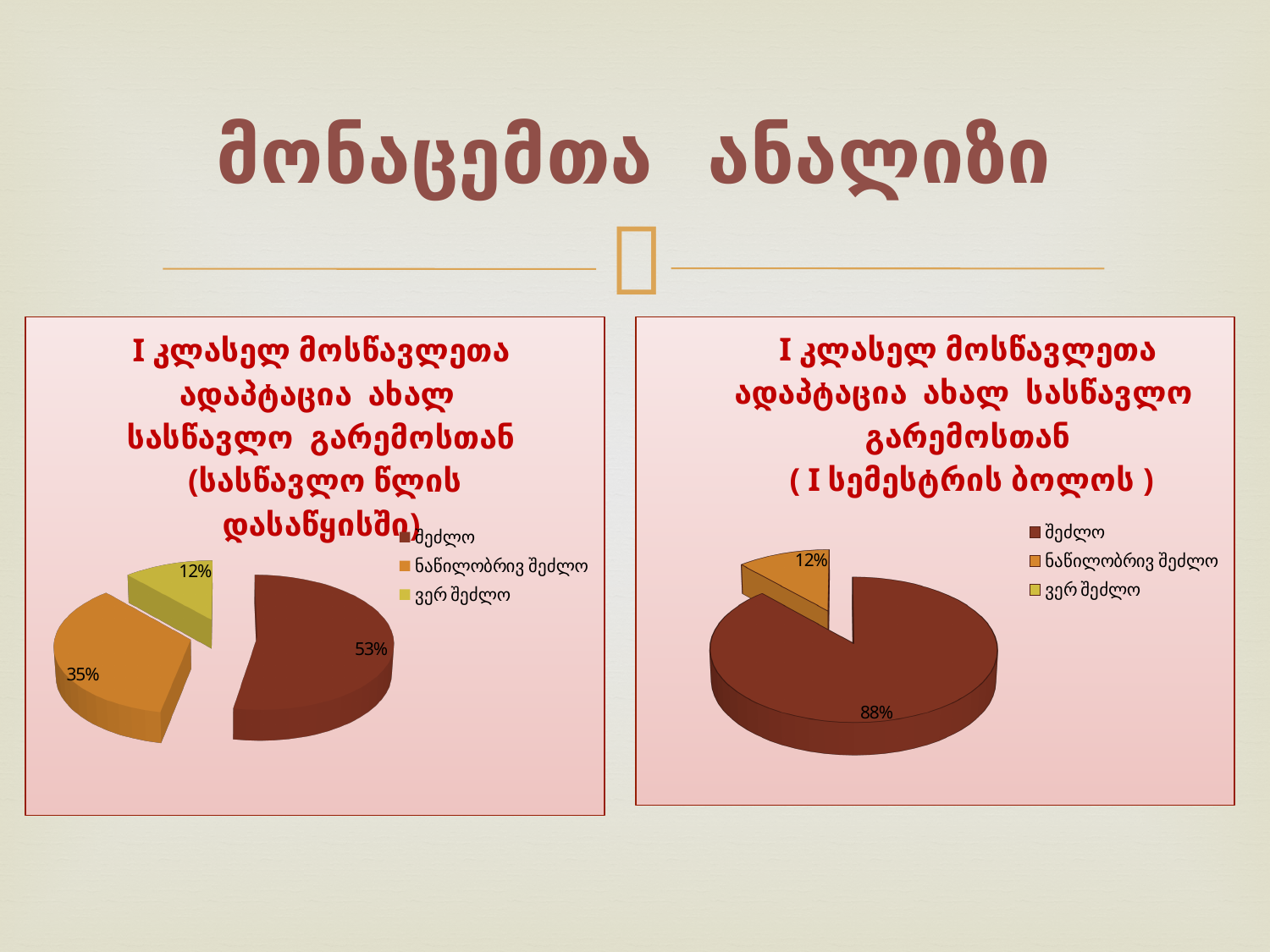
In the right pie chart, what percentage is shown for the შეძლო slice? 88% In the left pie chart, what percentage is shown for the შეძლო slice? 53% In the left pie chart, what percentage is shown for the ნაწილობრივ შეძლო slice? 35% Which chart shows a larger share for შეძლო, the left chart or the right chart? the right chart In the left pie chart, what percentage is shown for the ვერ შეძლო slice? 12% In the right pie chart, what percentage is shown for the ნაწილობრივ შეძლო slice? 12% In the left pie chart, which category has the smallest slice? ვერ შეძლო In the left pie chart, what is the difference between the შეძლო and ნაწილობრივ შეძლო percentages? 18% How many entries does the legend of the right pie chart list? 3 In the right pie chart, what is the difference between the შეძლო and ნაწილობრივ შეძლო percentages? 76% In the left pie chart, which category has the largest slice? შეძლო What type of chart is used on the left side of the slide? pie chart